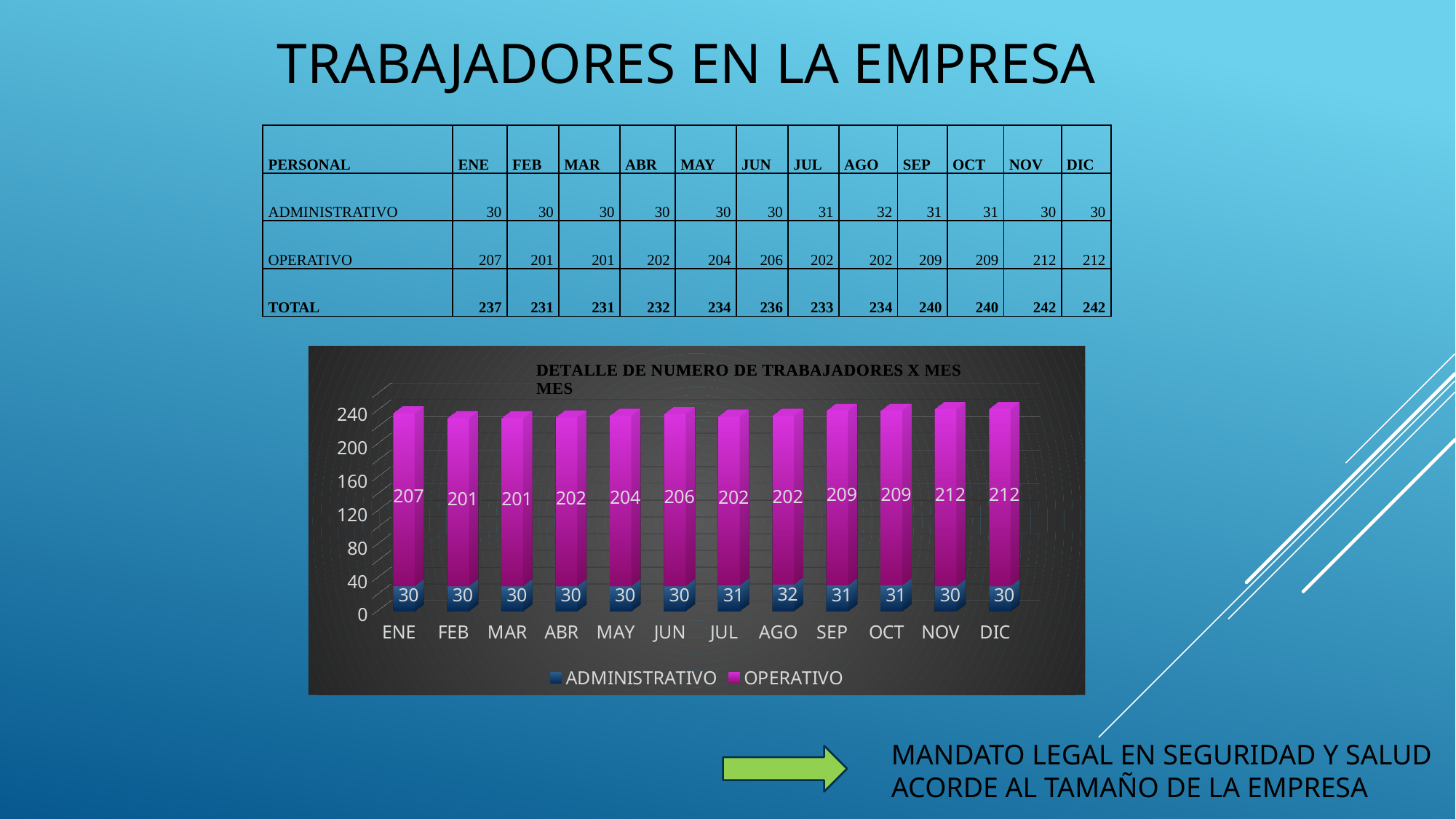
In which month is the ADMINISTRATIVO value highest? AGO How many series does the chart legend list? 2 What kind of chart is shown on the slide? Stacked bar chart In the chart, what is the OPERATIVO value for ENE? 207 How many months are shown on the x axis of the chart? 12 Which month has the larger OPERATIVO value, SEP or JUL? SEP What is the title of the chart? DETALLE DE NUMERO DE TRABAJADORES X MES In the chart, what is the OPERATIVO value for MAY? 204 In the chart, what is the ADMINISTRATIVO value for AGO? 32 What is the difference between the OPERATIVO values for DIC and FEB? 11 Which series is shown in blue in the chart? ADMINISTRATIVO What is the total height of the stacked bar for ENE (ADMINISTRATIVO plus OPERATIVO)? 237